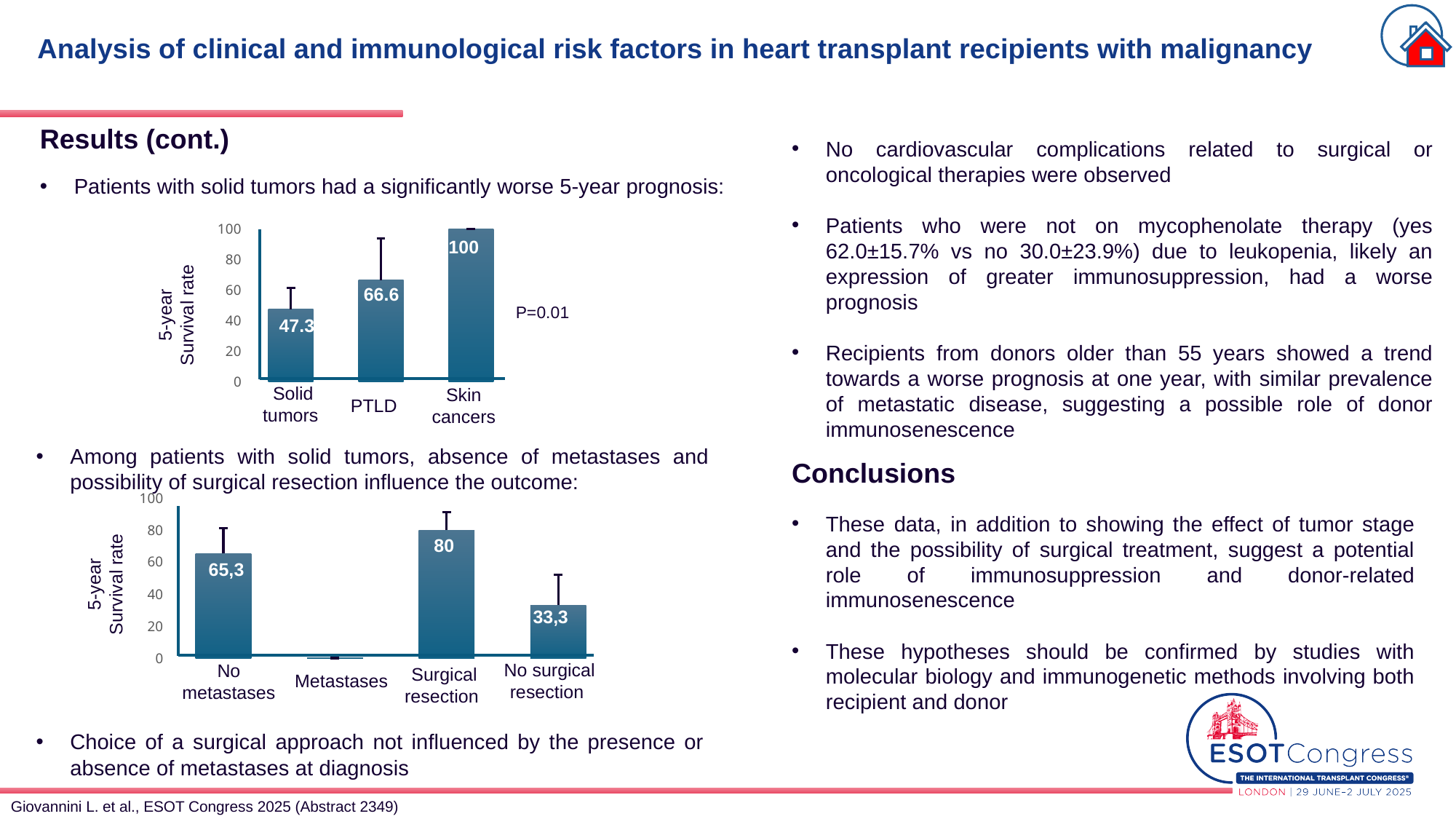
In the upper chart, what is the difference between the survival rate for skin cancers and for solid tumors? 52.7 In the lower chart, is the value for no metastases greater or less than 60? greater What kind of chart is the lower chart? Bar chart In the upper chart, what is the 5-year survival rate for solid tumors? 47.3 In the upper chart, which category has the highest 5-year survival rate? Skin cancers In the upper chart, how many categories are plotted? 3 In the lower chart, what is the 5-year survival rate for surgical resection? 80 In the lower chart, which category has the lowest 5-year survival rate? Metastases In the upper chart, what P value is shown next to the bars? P=0.01 In the lower chart, what is the 5-year survival rate for no surgical resection? 33,3 In the upper chart, which category has the lowest 5-year survival rate? Solid tumors In the upper chart, what is the 5-year survival rate for PTLD? 66.6